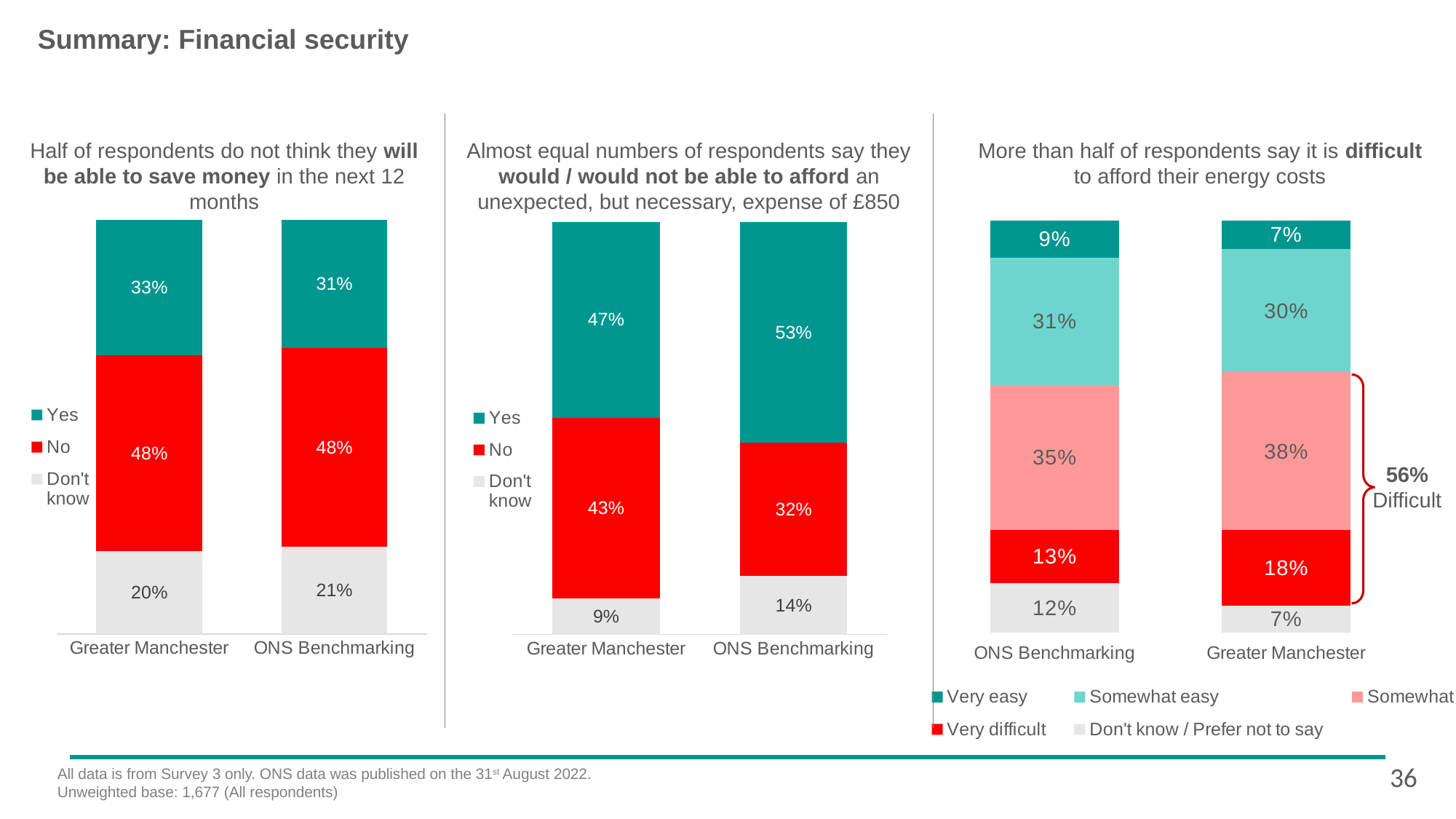
In the middle chart about affording an unexpected expense of £850, what percentage of Greater Manchester respondents answered Yes? 47% In the left chart about saving money in the next 12 months, what percentage of ONS Benchmarking respondents answered Yes? 31% In the left chart about saving money in the next 12 months, what is the difference between the Yes percentages for Greater Manchester and ONS Benchmarking? 2% In the left chart about saving money in the next 12 months, what percentage of Greater Manchester respondents answered No? 48% In the right chart about affording energy costs, what percentage of Greater Manchester respondents said Very difficult? 18% In the middle chart about affording an unexpected expense of £850, what is the difference between the Don't know percentages for ONS Benchmarking and Greater Manchester? 5% In the right chart about affording energy costs, what percentage of ONS Benchmarking respondents said Somewhat easy? 31% What kind of chart is the middle chart about affording an unexpected expense of £850? Stacked bar chart In the right chart about affording energy costs, which group has the larger Very easy percentage, ONS Benchmarking or Greater Manchester? ONS Benchmarking How many series does the legend of the left chart about saving money list? 3 In the middle chart about affording an unexpected expense of £850, which group has the larger No percentage, Greater Manchester or ONS Benchmarking? Greater Manchester In the right chart about affording energy costs, what combined percentage of Greater Manchester respondents is labelled as Difficult by the bracket? 56%